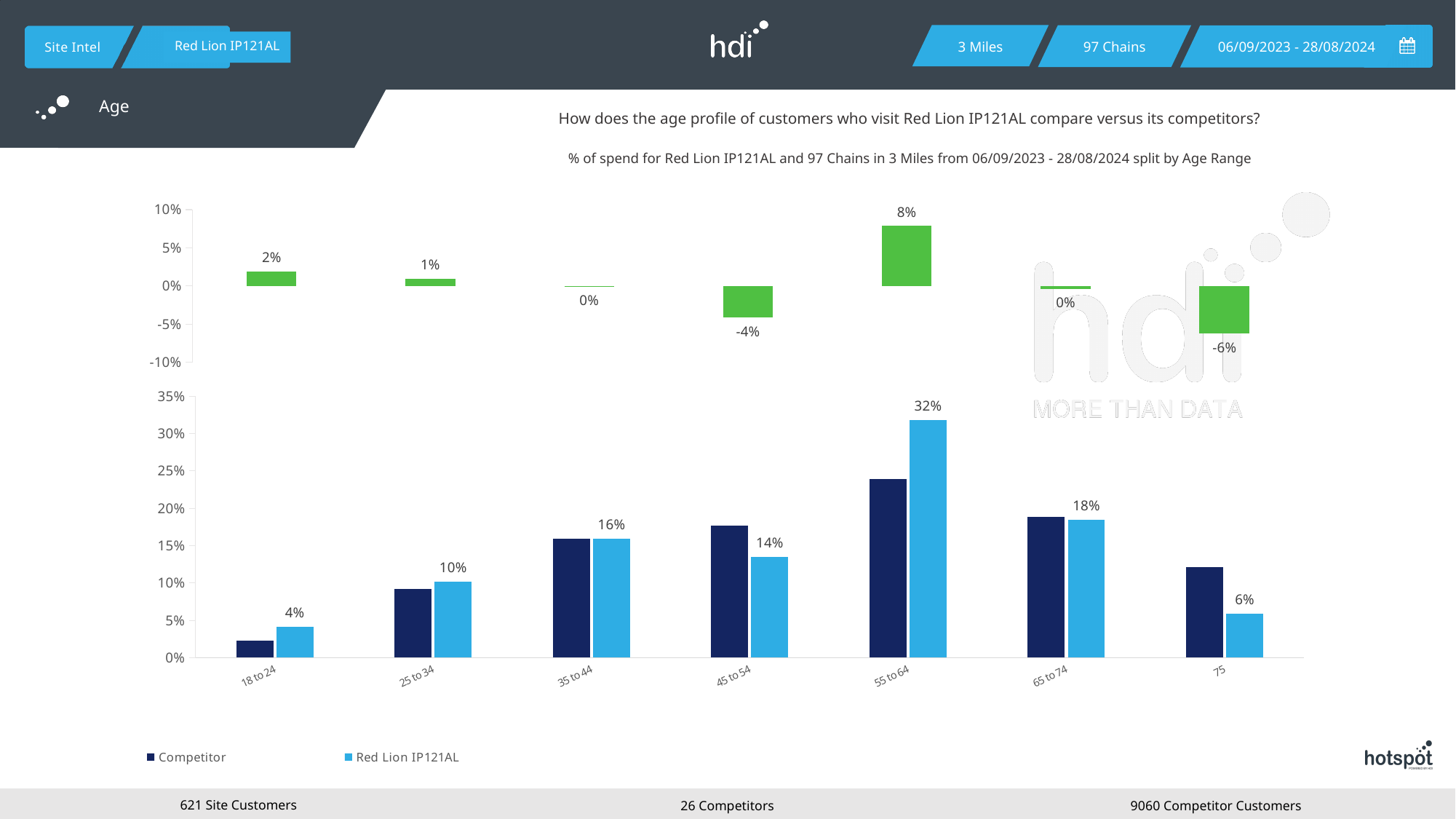
How many series does the legend of the bottom bar chart list? 2 In the top chart, which age range has the lowest value? 75 In the bottom bar chart, is the Competitor value for 55 to 64 greater or less than 20%? greater In the bottom bar chart, which age range has the lowest Red Lion IP121AL value? 18 to 24 In the bottom bar chart, is the Competitor value for 18 to 24 greater or less than 5%? less In the bottom bar chart, what is the Red Lion IP121AL value for the 18 to 24 age range? 4% In the top chart, what is the value shown for the 55 to 64 age range? 8% In the bottom bar chart, which age range has the highest Red Lion IP121AL value? 55 to 64 In the bottom bar chart, what is the Red Lion IP121AL value for the 55 to 64 age range? 32% In the bottom bar chart, what is the difference between the Red Lion IP121AL values for 55 to 64 and 65 to 74? 14% In the bottom bar chart, is the Red Lion IP121AL value for 35 to 44 or for 45 to 54 larger? 35 to 44 How many age range categories are shown on the bottom bar chart? 7